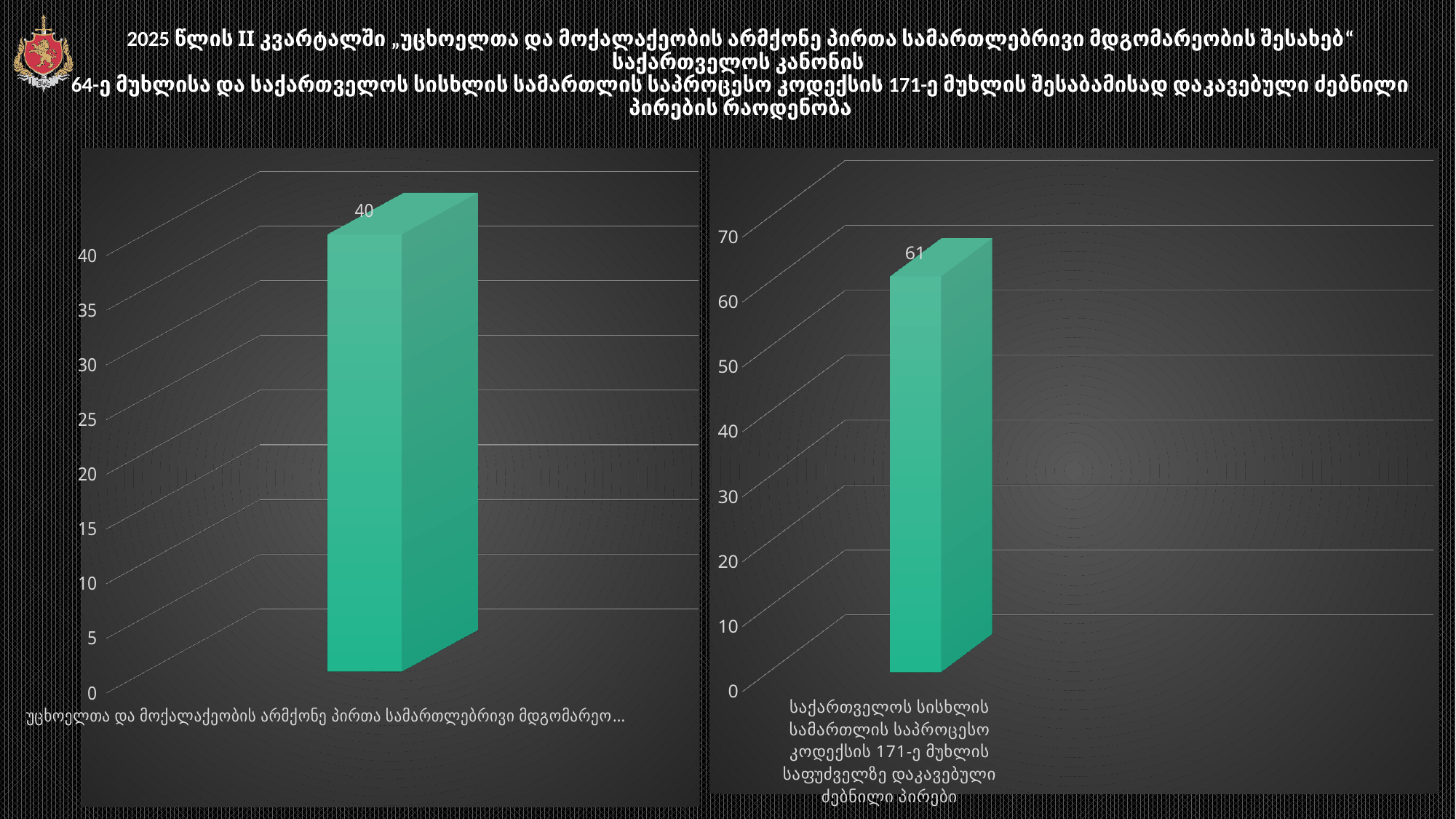
What is the highest tick value shown on the vertical axis of the right chart? 70 On the left chart, is the value of the bar greater or less than 30? greater What kind of chart is the right chart? bar chart On the left chart, what value is shown for the single bar? 40 How many bars are plotted on the right chart? 1 On the right chart, is the value of the bar greater or less than 50? greater Which chart shows the larger value, the left chart or the right chart? the right chart What is the difference between the value on the right chart (61) and the value on the left chart (40)? 21 How many bars are plotted on the left chart? 1 What colour are the bars on both charts? green On the right chart, what value is shown for the bar labelled საქართველოს სისხლის სამართლის საპროცესო კოდექსის 171-ე მუხლის საფუძველზე დაკავებული ძებნილი პირები? 61 What kind of chart is the left chart? bar chart